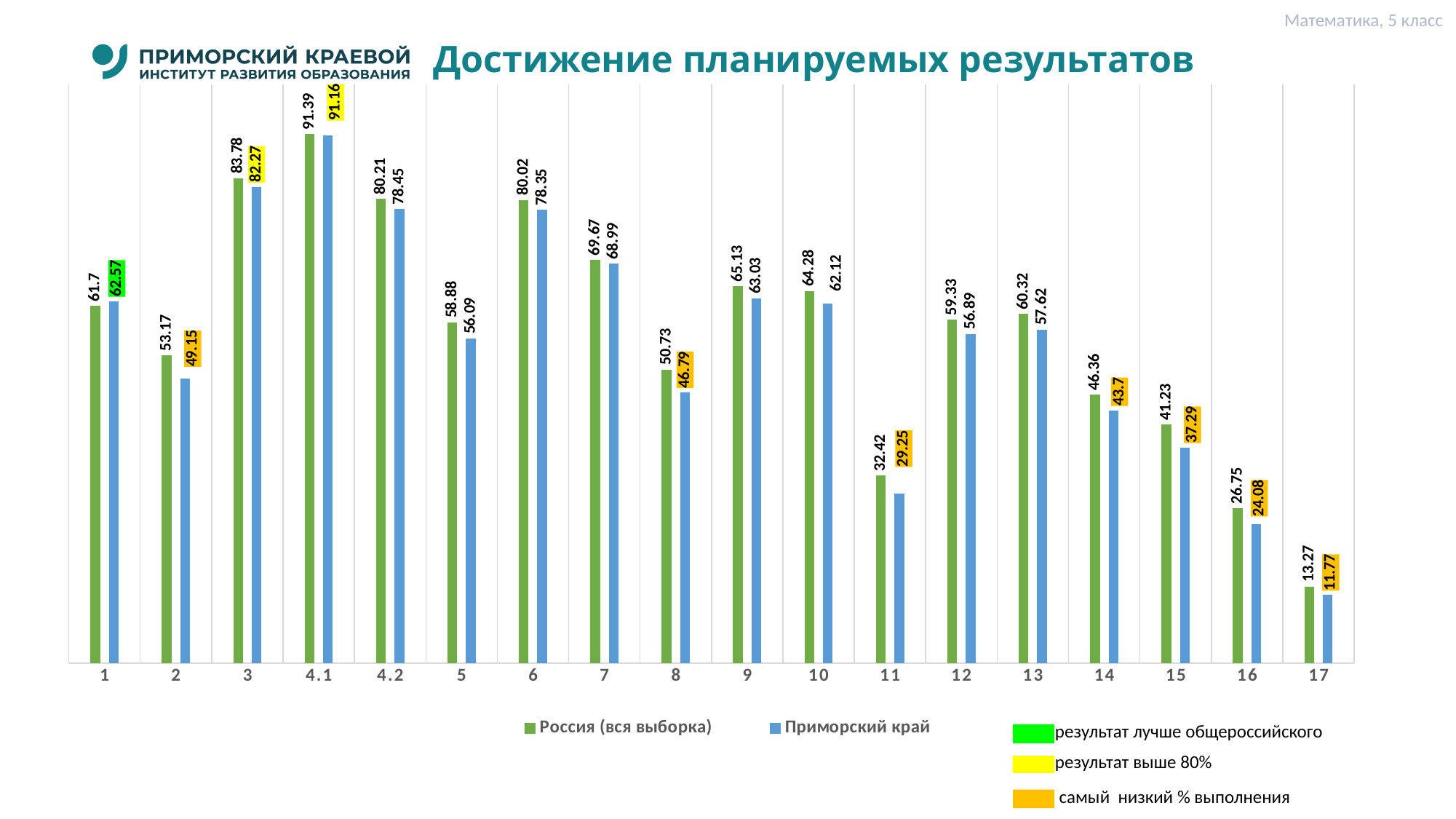
What is the difference between the Россия (вся выборка) and Приморский край values for task 8? 3.94 Which task has the lowest value for Приморский край? 17 For task 1, which series has the larger value: Россия (вся выборка) or Приморский край? Приморский край What does the yellow highlight on a data label indicate, according to the legend? результат выше 80% What is the value for Россия (вся выборка) for task 11? 32.42 What kind of chart is shown on the slide? Bar chart What is the value for Приморский край for task 15? 37.29 How many data series does the legend list? 2 What is the difference between the Россия (вся выборка) and Приморский край values for task 2? 4.02 Which task has the highest value for Россия (вся выборка)? 4.1 How many task categories are shown on the x axis? 18 What is the value for Приморский край for task 4.1? 91.16